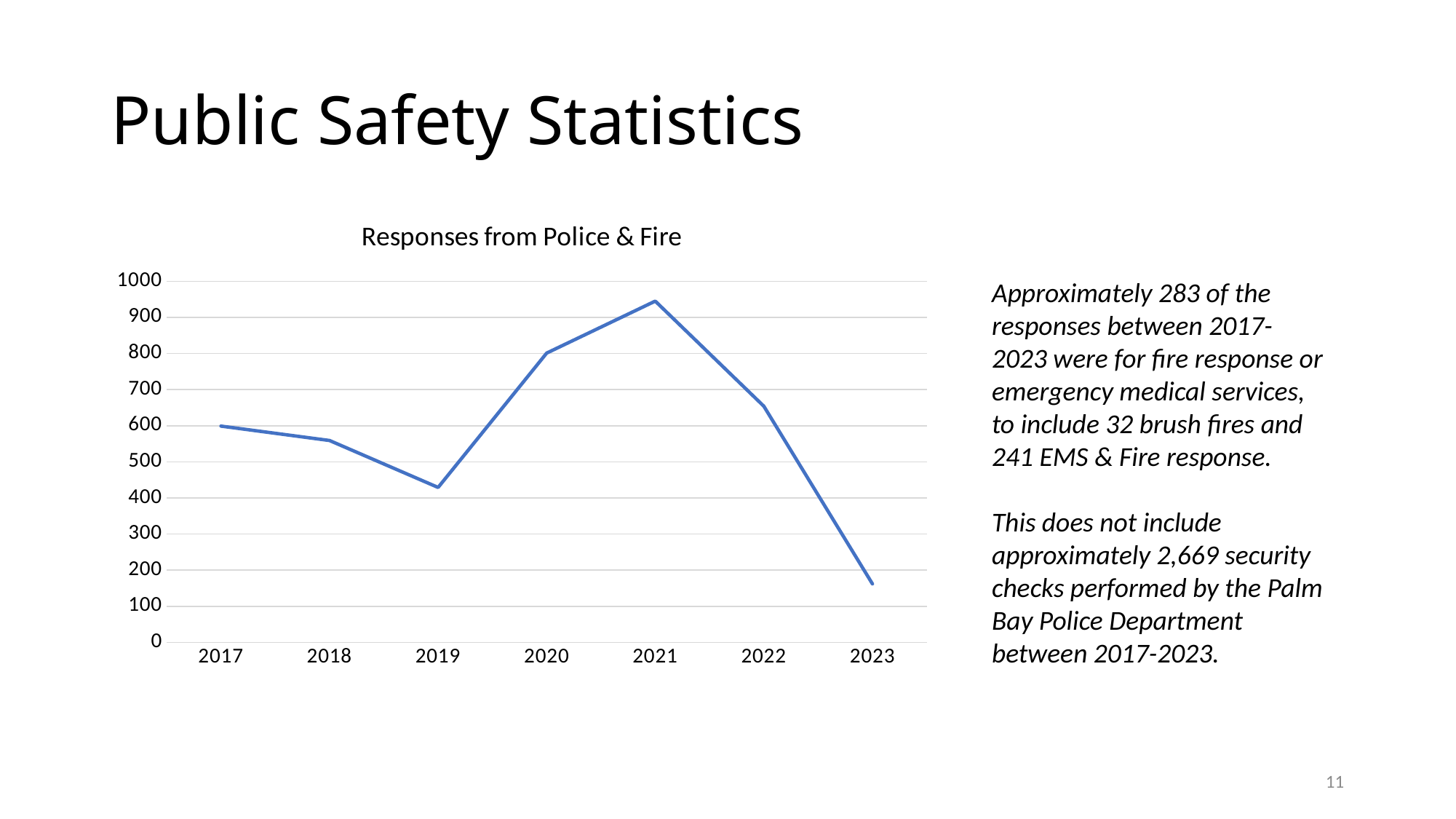
Which year has the highest number of responses? 2021 Is the value for 2022 greater or less than 600? greater Do the responses rise or fall from 2021 to 2023? fall What is the title of the chart? Responses from Police & Fire How many years are plotted on the x axis of the chart? 7 Which year has more responses, 2017 or 2019? 2017 Which year has the lowest number of responses? 2023 Is the value for 2019 greater or less than 500? less Which year has more responses, 2018 or 2020? 2020 What kind of chart is shown on the slide? line chart Is the value for 2023 greater or less than 200? less